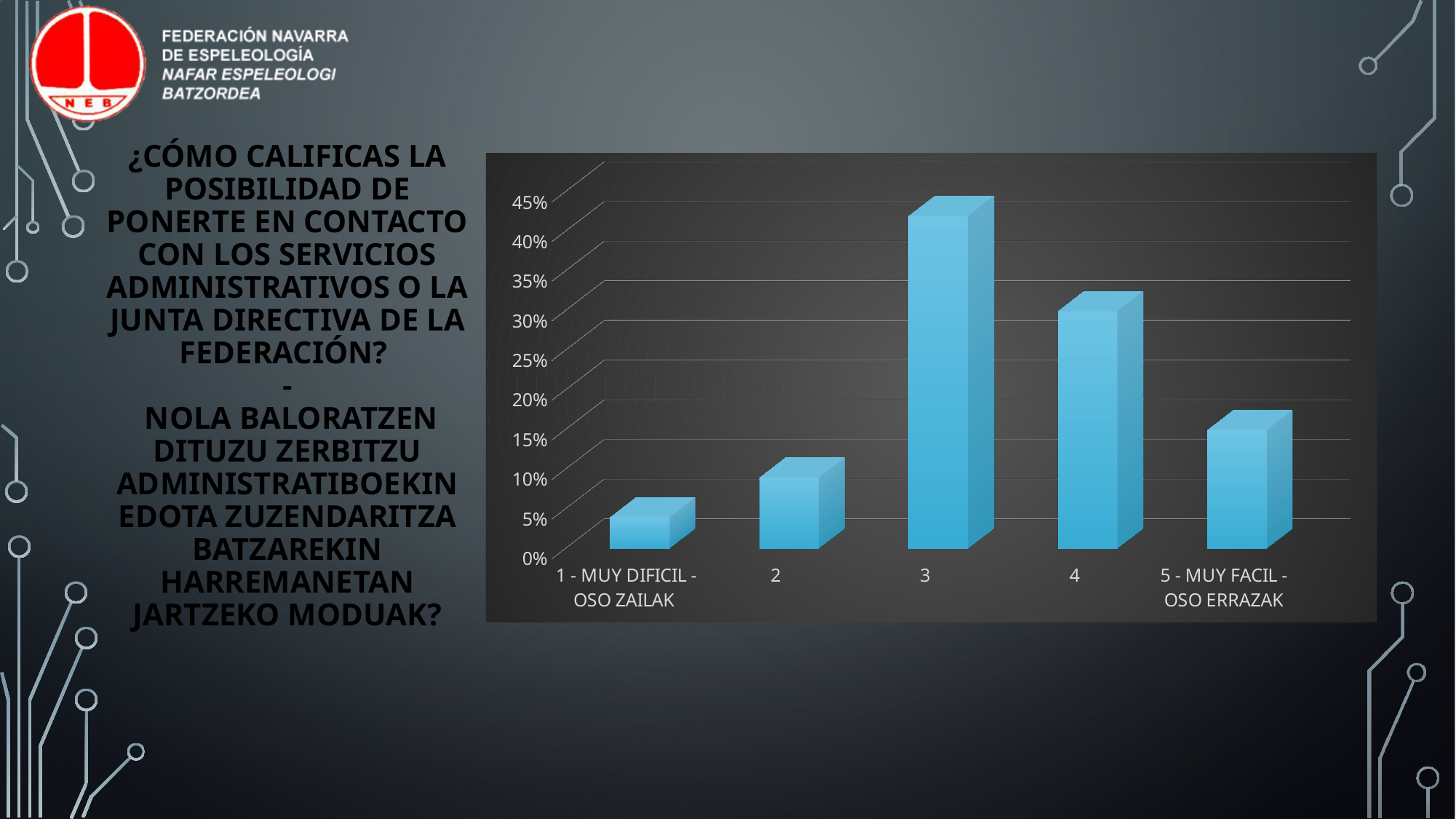
How many categories are shown on the x axis of the chart? 5 Which is larger, the value for category 4 or the value for 5 - MUY FACIL - OSO ERRAZAK? 4 What kind of chart is shown on the slide? bar chart Is the value for category 2 greater or less than 15%? less Is the value for category 3 greater or less than 35%? greater Which category has the lowest bar in the chart? 1 - MUY DIFICIL - OSO ZAILAK Is the value for 5 - MUY FACIL - OSO ERRAZAK greater or less than 10%? greater What is the highest value shown on the vertical axis of the chart? 45% Which is larger, the value for category 2 or the value for category 3? 3 Which category has the highest bar in the chart? 3